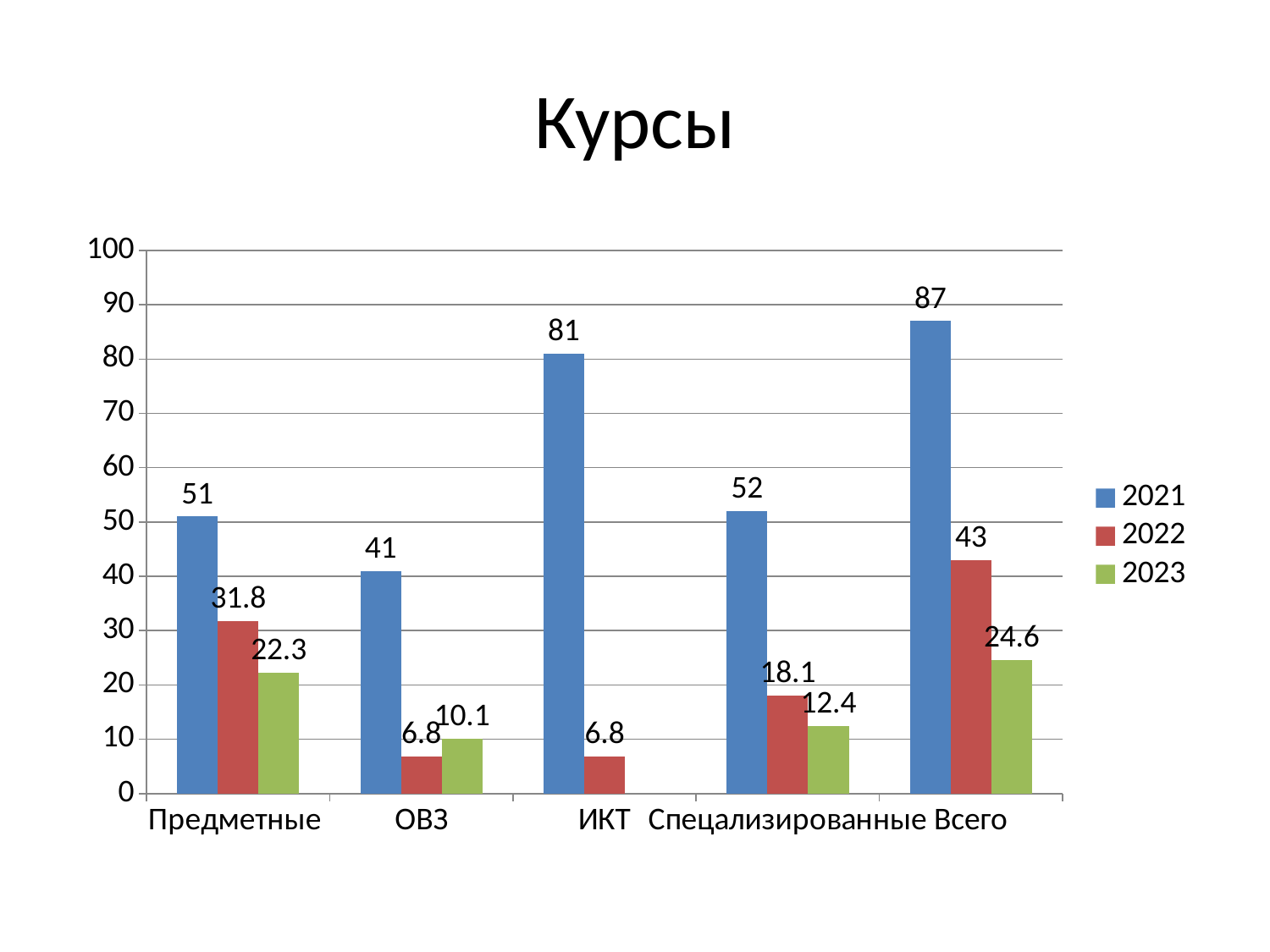
What is the value for 2022 in the Спецализированные category? 18.1 Which is larger: the 2021 value for ИКТ or the 2021 value for Спецализированные? ИКТ How many series does the legend list? 3 What kind of chart is shown on the slide? bar chart How many categories are shown on the x axis? 5 Which category has the lowest value for the 2023 series? ОВЗ What is the value for 2021 in the Предметные category? 51 What is the title of the chart? Курсы Is the 2021 value for ОВЗ greater or less than 50? less What is the value for 2023 in the Всего category? 24.6 What is the difference between the 2021 and 2022 values in the Всего category? 44 Which category has the highest value for the 2021 series? Всего